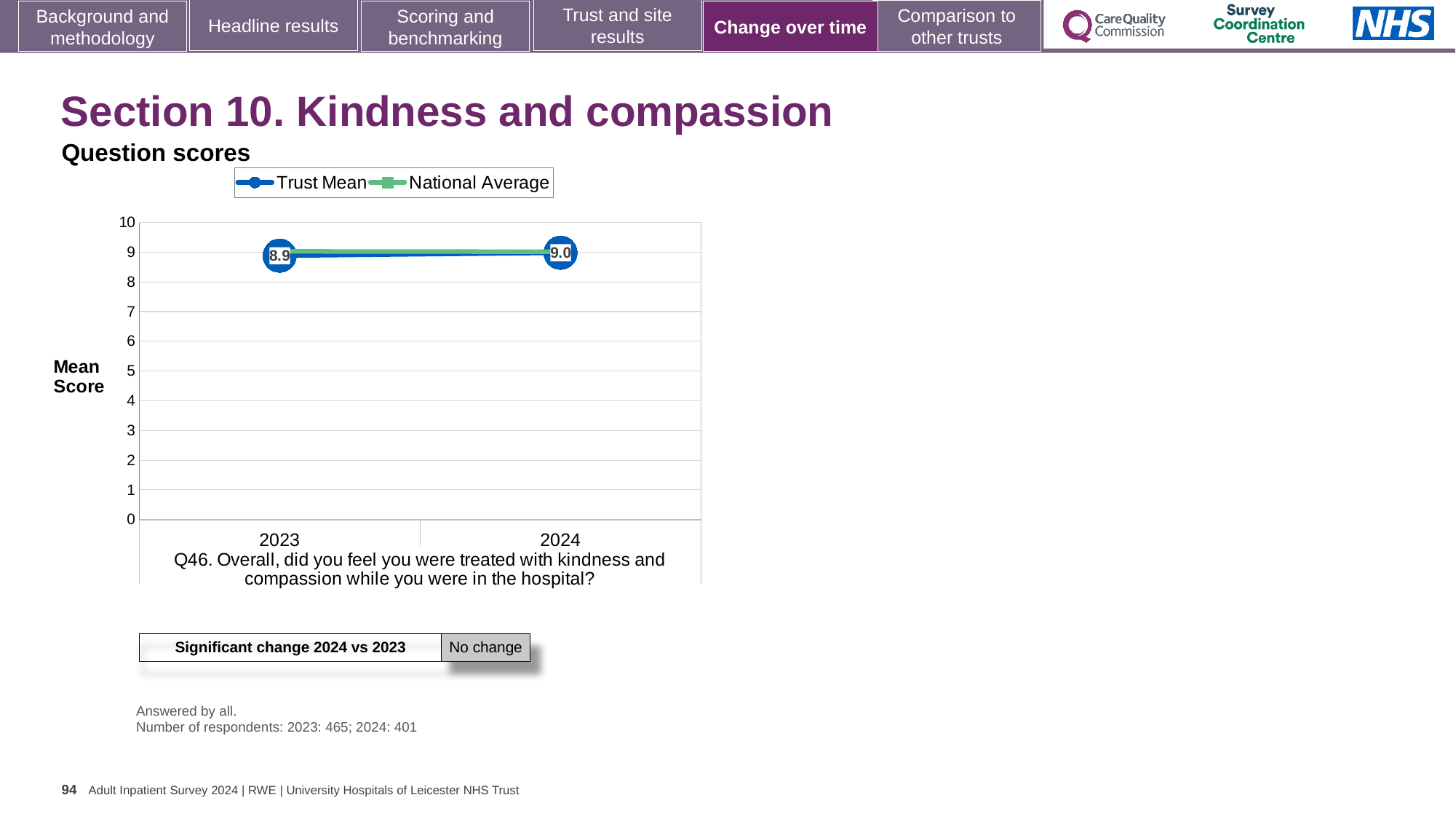
How many years are shown on the x axis? 2 What is the Trust Mean value for 2023? 8.9 Is the National Average value for 2023 greater or less than 5? greater How many series does the legend list? 2 What is the difference between the Trust Mean values for 2024 and 2023? 0.1 Is the National Average value for 2024 greater or less than 8? greater What is the label on the y axis of the chart? Mean Score In which year is the Trust Mean highest? 2024 What is the Trust Mean value for 2024? 9.0 Does the Trust Mean rise or fall from 2023 to 2024? rise What kind of chart is shown on the slide? line chart Which year has the higher Trust Mean value, 2023 or 2024? 2024